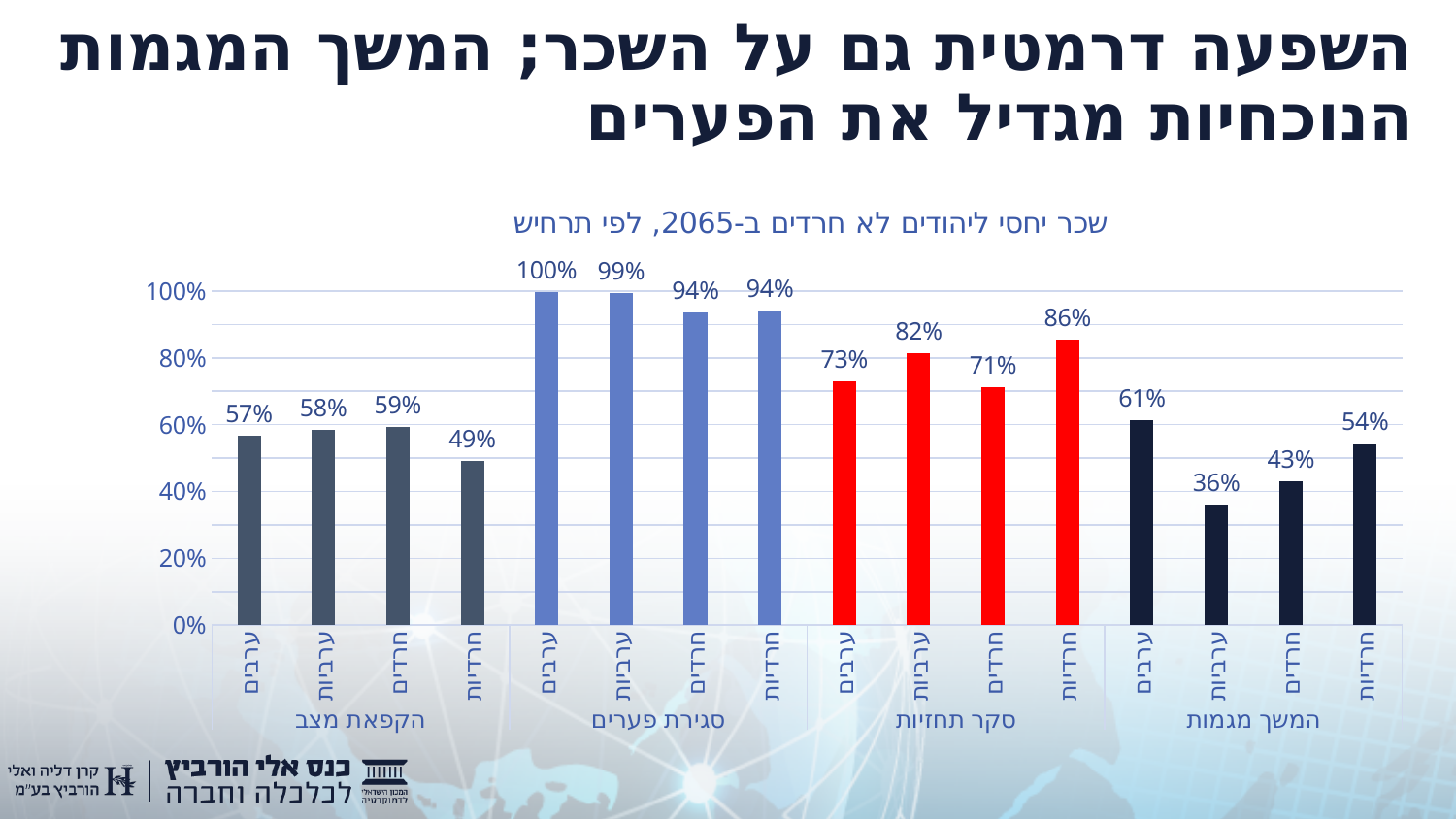
Which is larger: the value for חרדים in הקפאת מצב or the value for חרדים in המשך מגמות? חרדים in הקפאת מצב (59%) What is the value for חרדיות in the סקר תחזיות group? 86% What is the title of the chart? שכר יחסי ליהודים לא חרדים ב-2065, לפי תרחיש How many bars are plotted on the chart? 16 Which bar has the highest value on the chart? ערבים in סגירת פערים (100%) Which bar has the lowest value on the chart? ערביות in המשך מגמות (36%) How many scenario groups are shown along the x axis? 4 What is the difference between the value for ערביות in סקר תחזיות and the value for ערביות in המשך מגמות? 46% What is the value for ערביות in the המשך מגמות group? 36% What kind of chart is shown on the slide? Bar chart What is the value for חרדיות in the הקפאת מצב group? 49% What is the value for ערבים in the סגירת פערים group? 100%